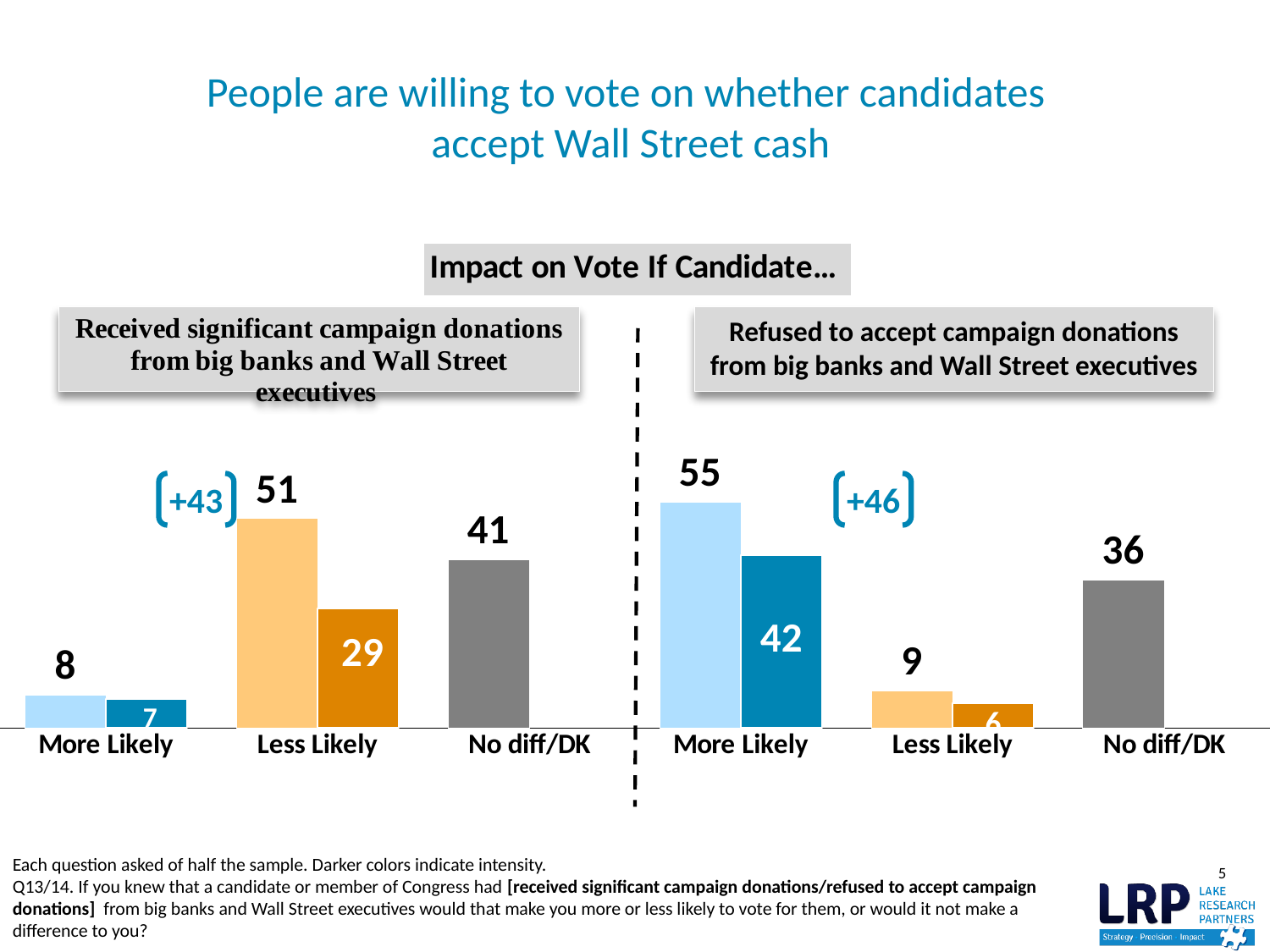
In the left chart (Received significant campaign donations), what is the difference between the Less Likely value (51) and the More Likely value (8)? 43 In the left chart (Received significant campaign donations), what is the value for Less Likely? 51 In the left chart (Received significant campaign donations), what is the value for No diff/DK? 41 In the right chart (Refused to accept campaign donations), which category has the lowest value? Less Likely How many categories are shown on the x axis of the left chart (Received significant campaign donations)? 3 In the right chart (Refused to accept campaign donations), which is larger: More Likely or No diff/DK? More Likely What net figure is shown in brackets above the right chart (Refused to accept campaign donations)? +46 In the right chart (Refused to accept campaign donations), what is the value for No diff/DK? 36 In the right chart (Refused to accept campaign donations), what is the value for More Likely? 55 In the right chart (Refused to accept campaign donations), what is the value of the darker More Likely bar? 42 In the left chart (Received significant campaign donations), which category has the highest value? Less Likely What kind of chart is used on this slide? Bar chart